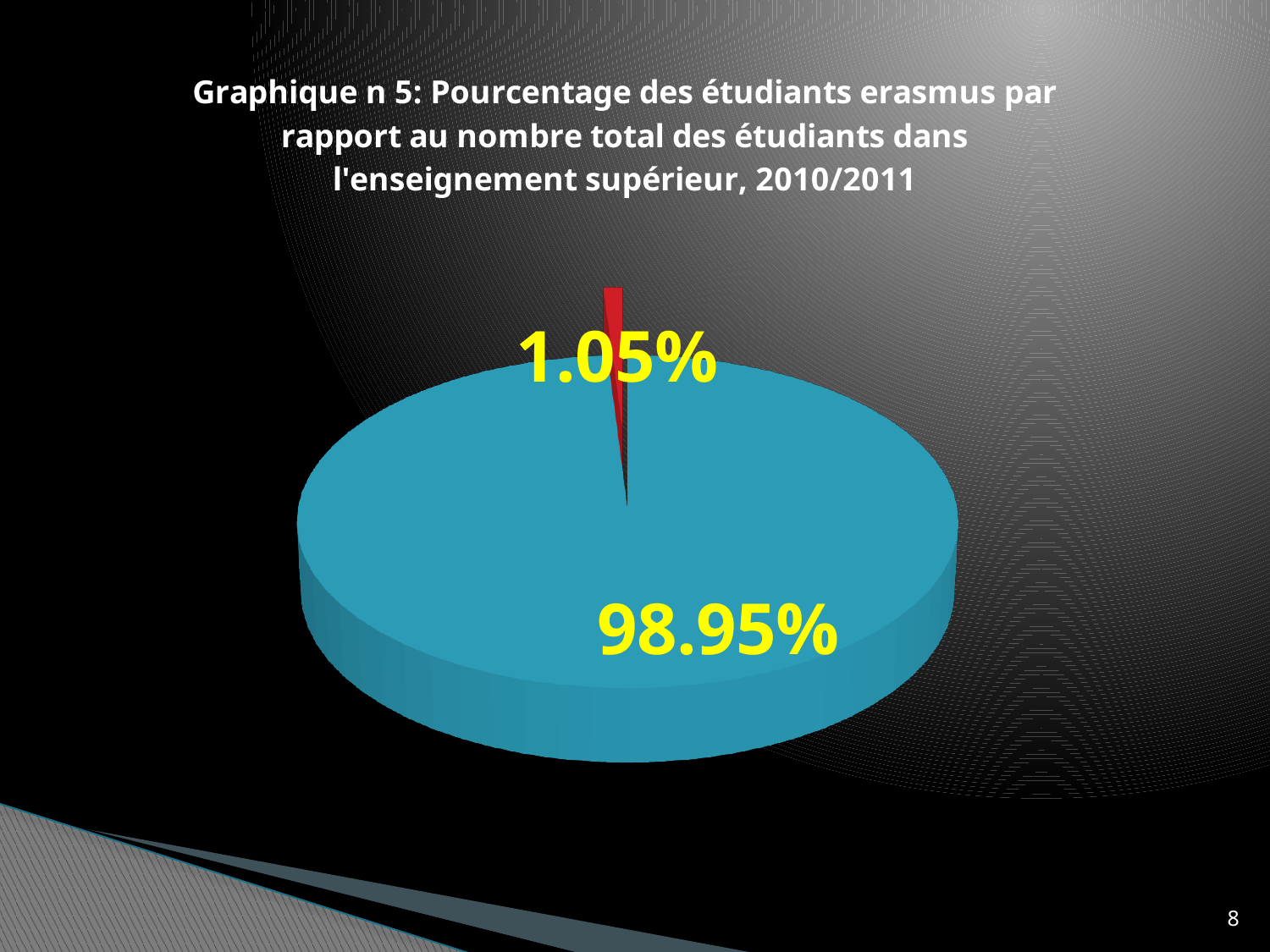
What academic year is mentioned in the chart title? 2010/2011 What is the smallest value shown on the pie chart? 1.05% What share of the pie does the small red slice represent? 1.05% What share of the pie does the large blue slice represent? 98.95% What kind of chart is shown on the slide? pie chart What do the two slice percentages add up to? 100% How many slices does the pie chart have? 2 What colour is the slice labelled 1.05%? red Is the value of the red slice greater or less than 5%? less What is the difference between the two percentages shown on the pie chart? 97.9% Which slice is larger, the blue one or the red one? the blue one What is the largest value shown on the pie chart? 98.95%